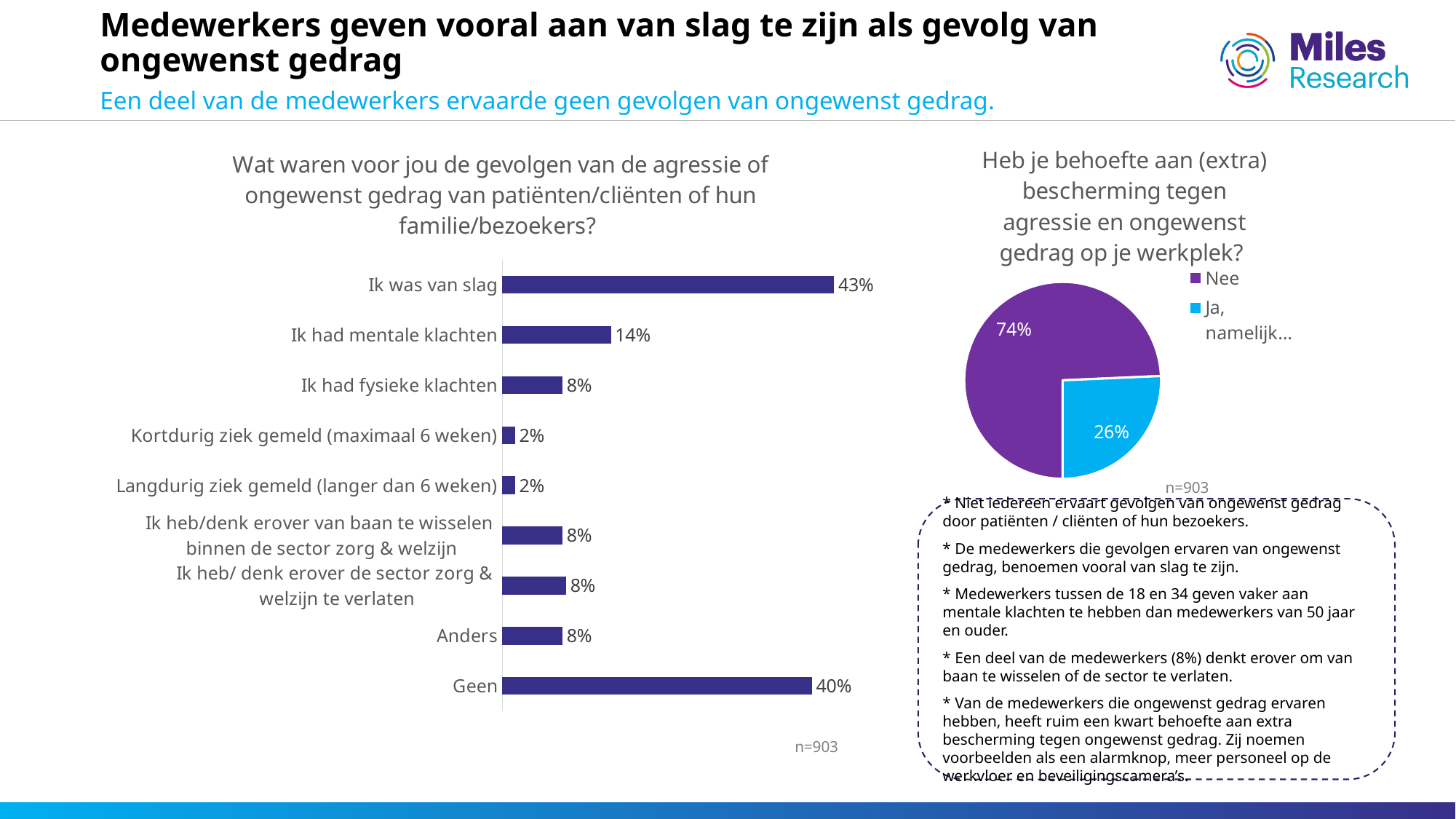
In the bar chart on the left, what is the value for "Geen"? 40% In the bar chart on the left, which is larger: "Ik had mentale klachten" or "Ik had fysieke klachten"? Ik had mentale klachten What kind of chart is the chart on the left? Bar chart In the pie chart on the right, what share is "Nee"? 74% In the bar chart on the left, which category has the highest value? Ik was van slag In the pie chart on the right, what share is "Ja, namelijk..."? 26% In the pie chart on the right, what is the difference between the "Nee" and "Ja, namelijk..." slices? 48% How many entries does the legend of the pie chart on the right list? 2 In the bar chart on the left, what is the value for "Ik was van slag"? 43% In the bar chart on the left, what is the value for "Ik had mentale klachten"? 14% How many categories does the bar chart on the left show? 9 In the bar chart on the left, what is the difference between "Ik was van slag" and "Geen"? 3%